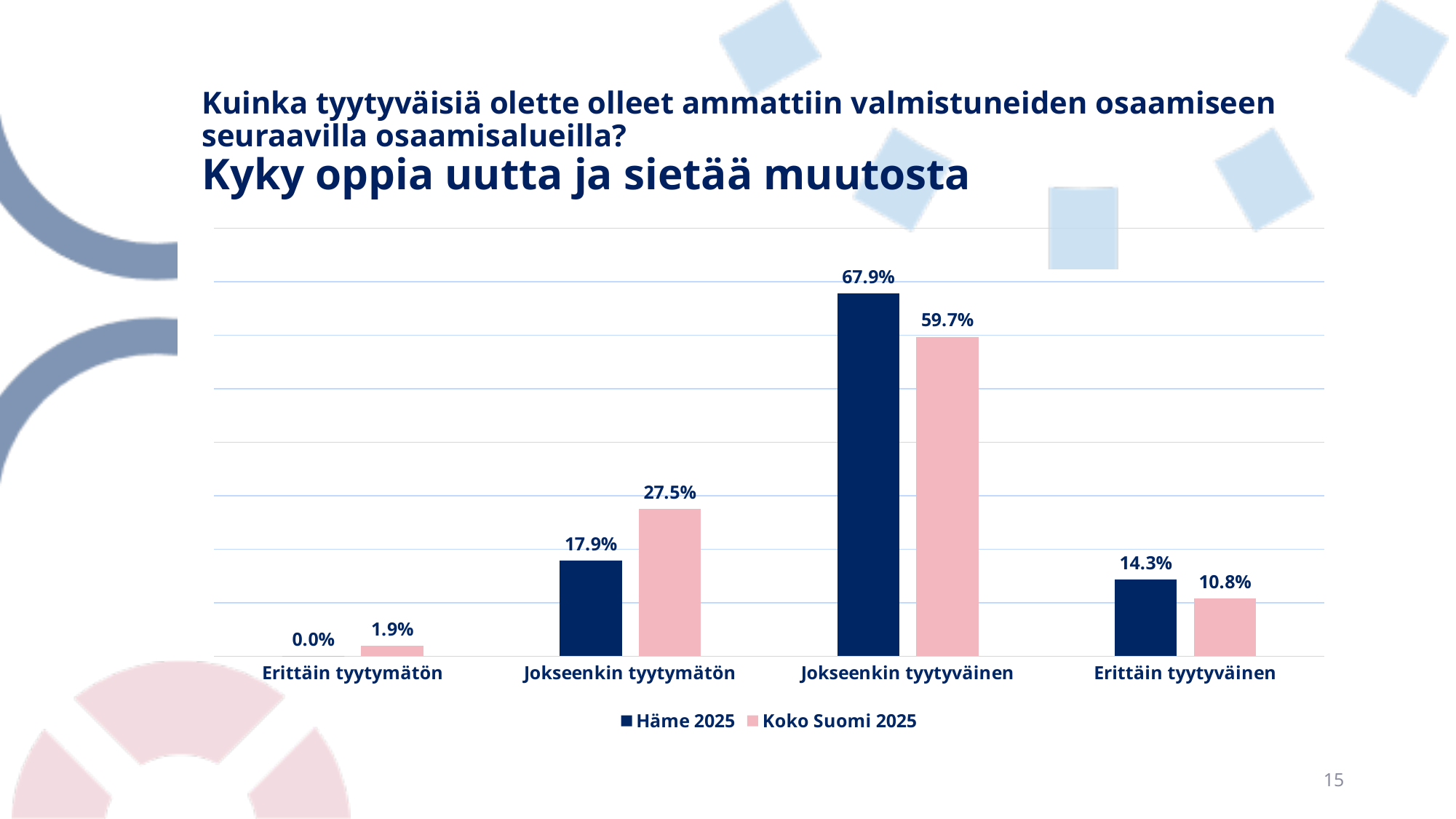
Which series is shown in pink in the legend? Koko Suomi 2025 How many series does the legend list? 2 What is the value for Koko Suomi 2025 in the Jokseenkin tyytymätön category? 27.5% What is the value for Häme 2025 in the Erittäin tyytymätön category? 0.0% What is the difference between Häme 2025 and Koko Suomi 2025 in the Jokseenkin tyytyväinen category? 8.2% What is the value for Häme 2025 in the Jokseenkin tyytyväinen category? 67.9% How many categories are shown on the x axis? 4 What is the value for Koko Suomi 2025 in the Erittäin tyytyväinen category? 10.8% In the Jokseenkin tyytymätön category, which series has the larger value, Häme 2025 or Koko Suomi 2025? Koko Suomi 2025 Which category has the highest value for Koko Suomi 2025? Jokseenkin tyytyväinen What kind of chart is shown on the slide? Bar chart Which category has the lowest value for Häme 2025? Erittäin tyytymätön